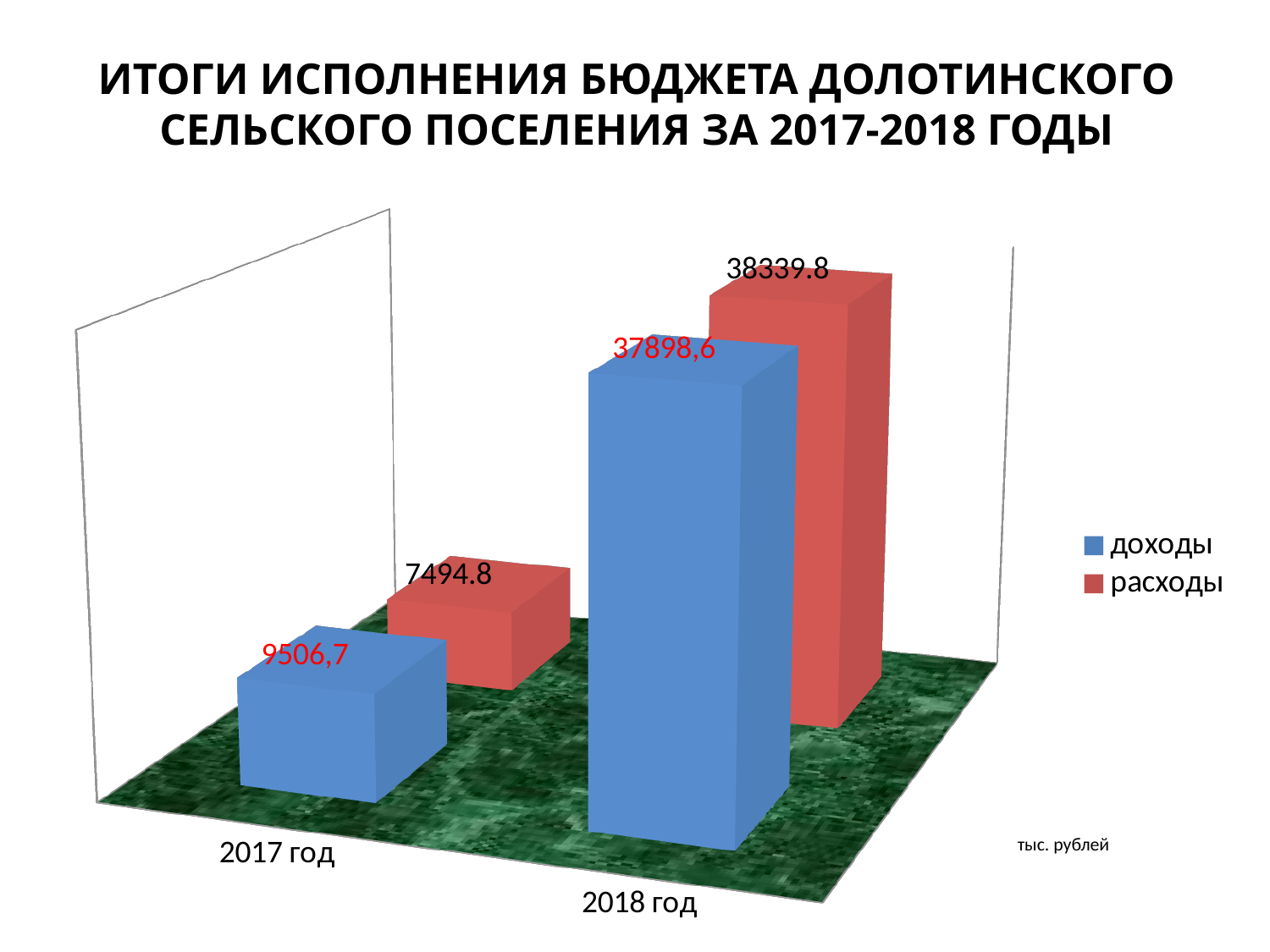
Which year has the lower value of доходы? 2017 год In 2017 год, which is larger: доходы or расходы? доходы What colour represents расходы in the chart? red What kind of chart is shown on the slide? bar chart How many series does the legend list? 2 What is the value of расходы for 2018 год? 38339.8 Which year has the higher value of расходы? 2018 год What is the value of доходы for 2017 год? 9506,7 What is the value of расходы for 2017 год? 7494.8 In 2018 год, which is larger: доходы or расходы? расходы What is the difference between расходы and доходы in 2018 год? 441.2 What is the value of доходы for 2018 год? 37898,6